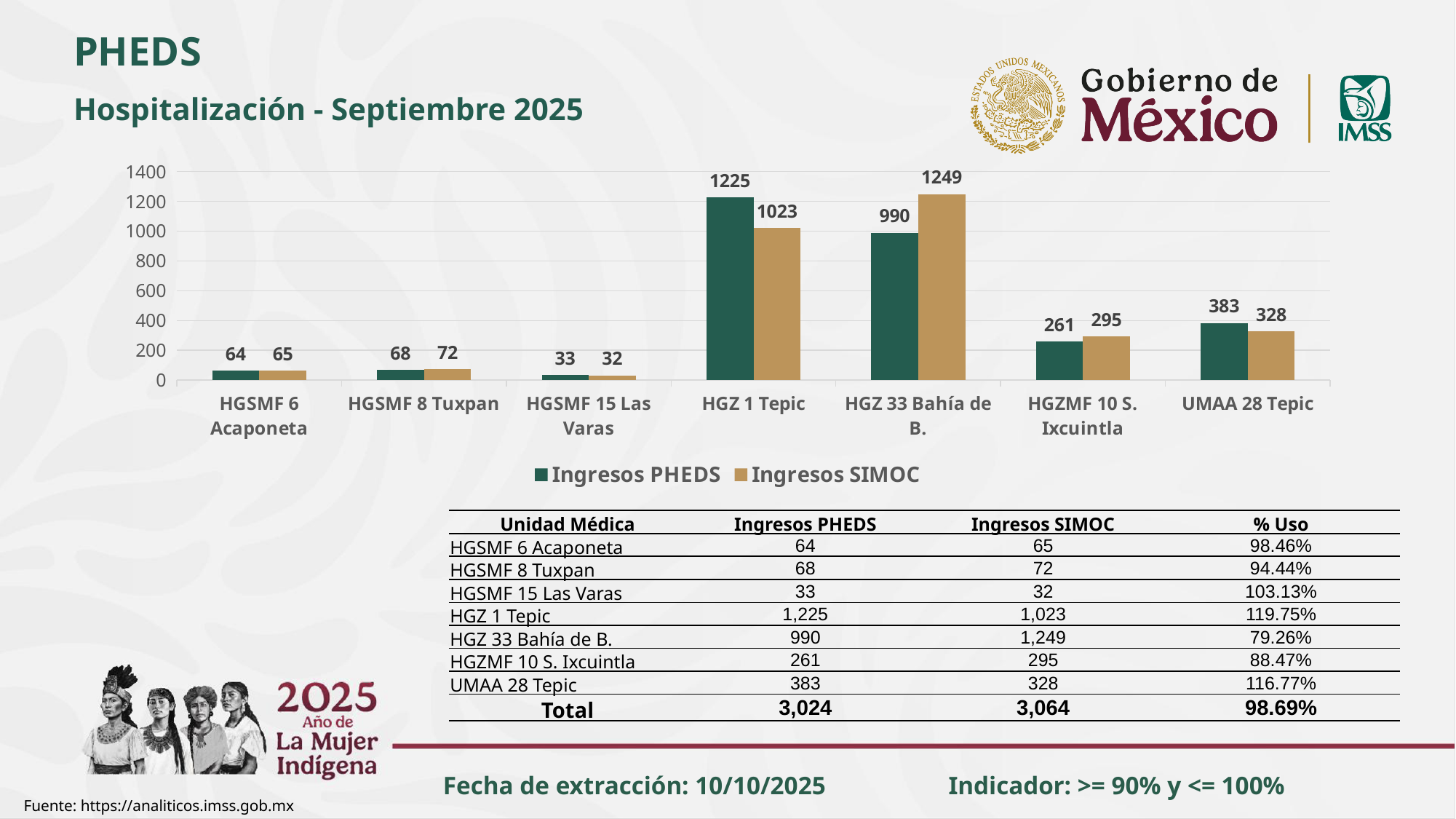
What colour are the Ingresos SIMOC bars in the chart? gold/tan What is the difference between Ingresos PHEDS and Ingresos SIMOC for HGZ 33 Bahía de B.? 259 What is the Ingresos PHEDS value for HGZ 1 Tepic? 1225 How many medical units are shown on the x axis of the chart? 7 How many series does the chart legend list? 2 Which unit has the lowest Ingresos SIMOC value? HGSMF 15 Las Varas Is the Ingresos PHEDS value for HGZ 33 Bahía de B. greater or less than 800? greater What is the Ingresos SIMOC value for UMAA 28 Tepic? 328 What is the Ingresos SIMOC value for HGZ 33 Bahía de B.? 1249 Which unit has the highest Ingresos PHEDS value? HGZ 1 Tepic For HGZMF 10 S. Ixcuintla, which is larger: Ingresos PHEDS or Ingresos SIMOC? Ingresos SIMOC What kind of chart is shown on the slide? bar chart